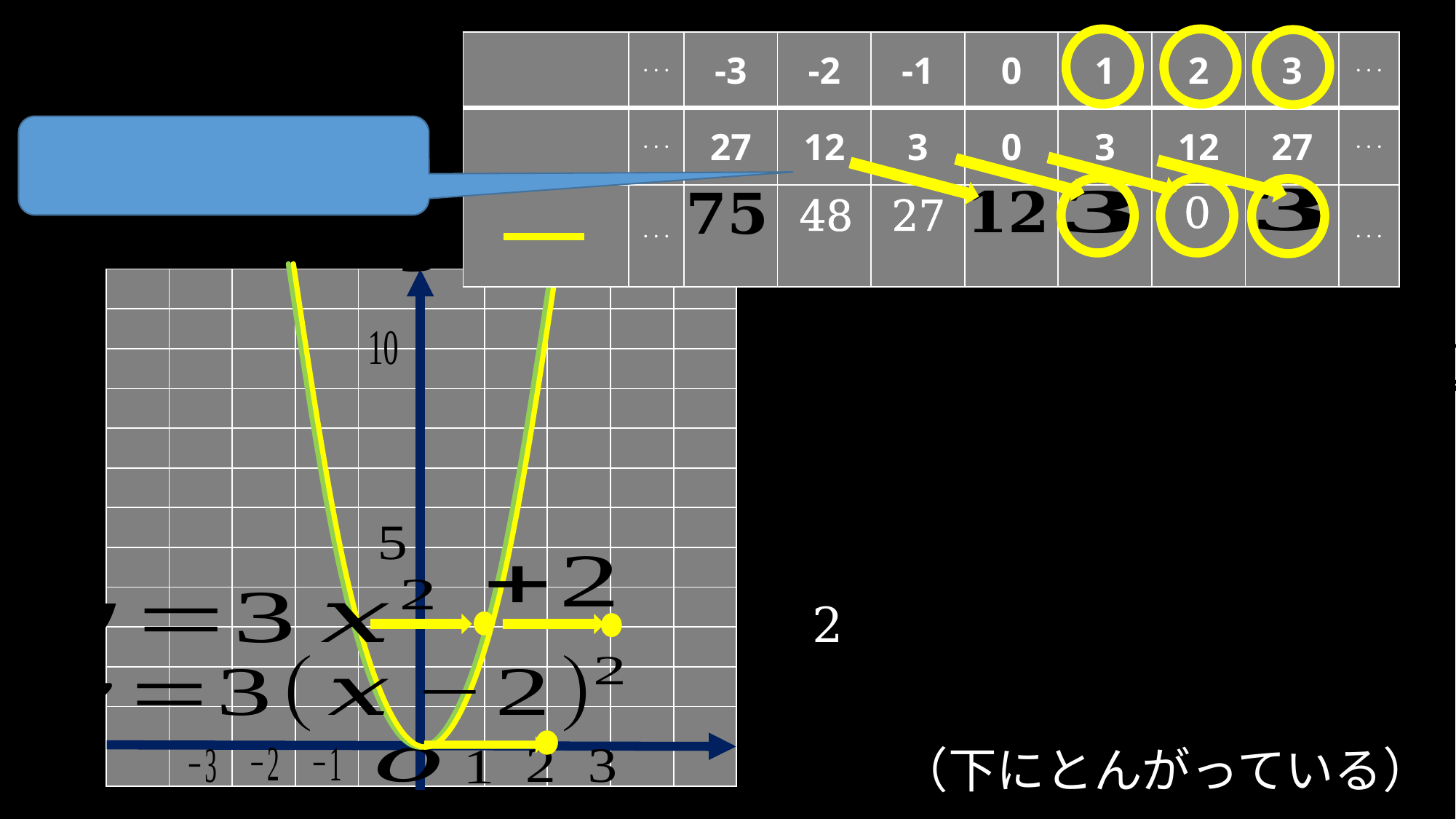
How many x values (not counting the ellipses) are listed in the header row of the table? 7 Which tick labels are shown on the y-axis of the graph? 5 and 10 In the table, do the third-row values rise or fall as x goes from -3 to 2? fall In the table, what is the value in the third row for x = 2? 0 On the graph, at which x value does the yellow parabola touch the x-axis? 2 In the table, at which x value does the second row reach its lowest value? 0 In the table, which is larger in the third row: the value at x = -2 or the value at x = 1? x = -2 (48) What kind of chart is drawn on the grid at the bottom left of the slide? line chart (parabola graph) In the table, what is the value in the third row for x = -3? 75 In the table, what is the value in the second row for x = -3? 27 In the table, at which x value does the third row reach its lowest value? 2 In the table, what is the difference between the third-row value and the second-row value at x = -3? 48